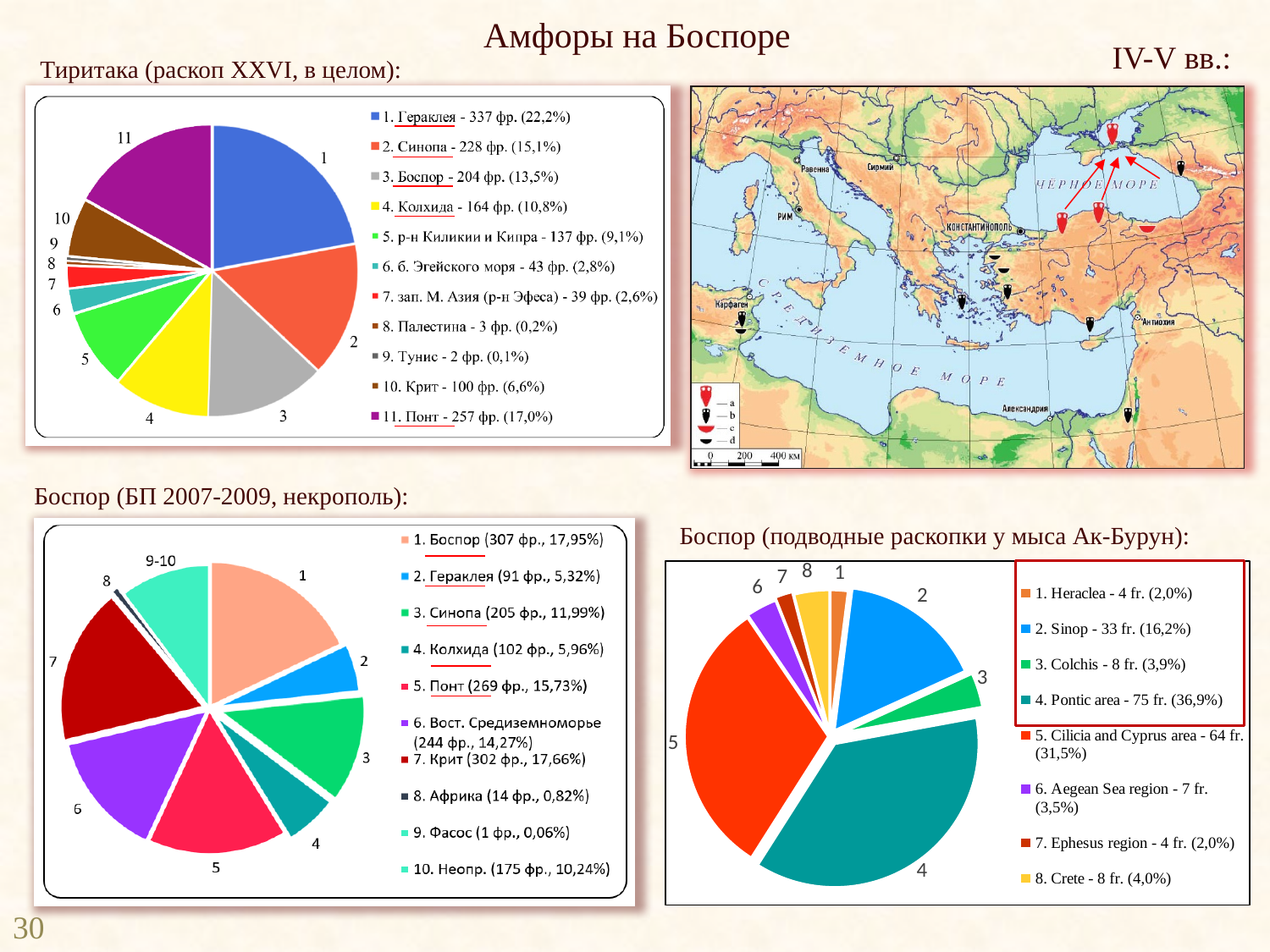
In the Тиритака (раскоп XXVI, в целом) chart, what is the difference in fragments between Синопа and Боспор? 24 In the Боспор (подводные раскопки у мыса Ак-Бурун) chart, what share does Pontic area have? 36,9% In the Тиритака (раскоп XXVI, в целом) chart, which category has the smallest number of fragments? Тунис What type of chart is used for Боспор (подводные раскопки у мыса Ак-Бурун)? Pie chart How many categories does the Тиритака (раскоп XXVI, в целом) pie chart have? 11 In the Тиритака (раскоп XXVI, в целом) chart, what share does Понт have? 17,0% How many categories does the Боспор (подводные раскопки у мыса Ак-Бурун) pie chart have? 8 In the Боспор (БП 2007-2009, некрополь) chart, how many fragments are listed for Крит? 302 фр. In the Боспор (подводные раскопки у мыса Ак-Бурун) chart, how many fragments are listed for Sinop? 33 fr. In the Боспор (БП 2007-2009, некрополь) chart, which category has the largest share? Боспор In the Тиритака (раскоп XXVI, в целом) chart, how many fragments are listed for Гераклея? 337 фр. In the Боспор (БП 2007-2009, некрополь) chart, which has more fragments, Понт or Вост. Средиземноморье? Понт